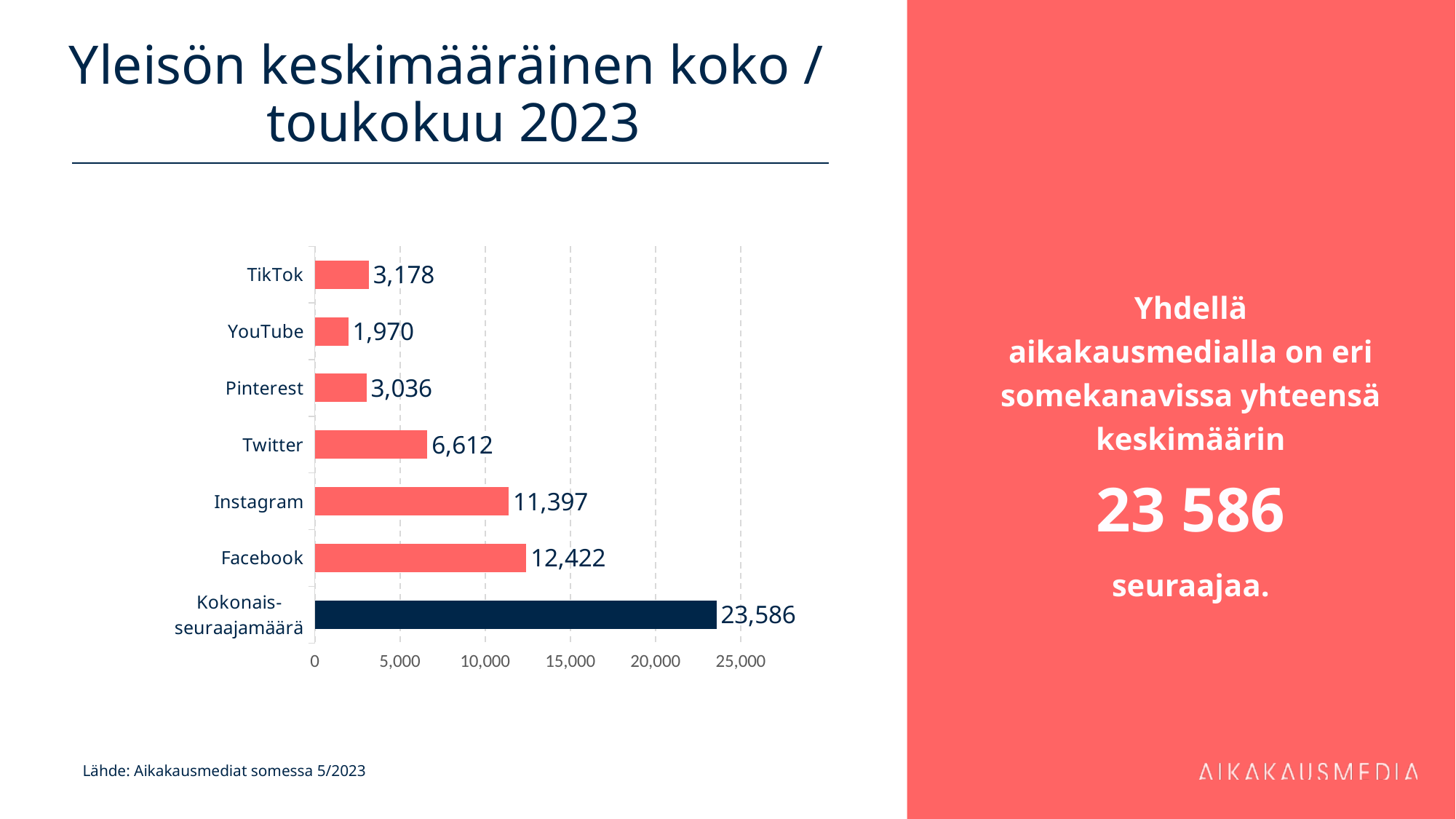
What is the value for Instagram? 11,397 What kind of chart is shown on the slide? Bar chart Which is larger, the value for TikTok or the value for Pinterest? TikTok Is the value for Twitter greater or less than 5,000? greater How many categories are shown in the chart? 7 What is the value for TikTok? 3,178 What is the value for Kokonais-seuraajamäärä? 23,586 What is the value for Facebook? 12,422 What is the difference between the values for Facebook and Instagram? 1,025 What is the difference between the values for Twitter and Pinterest? 3,576 Which individual social media channel has the highest value? Facebook Which category has the lowest value? YouTube